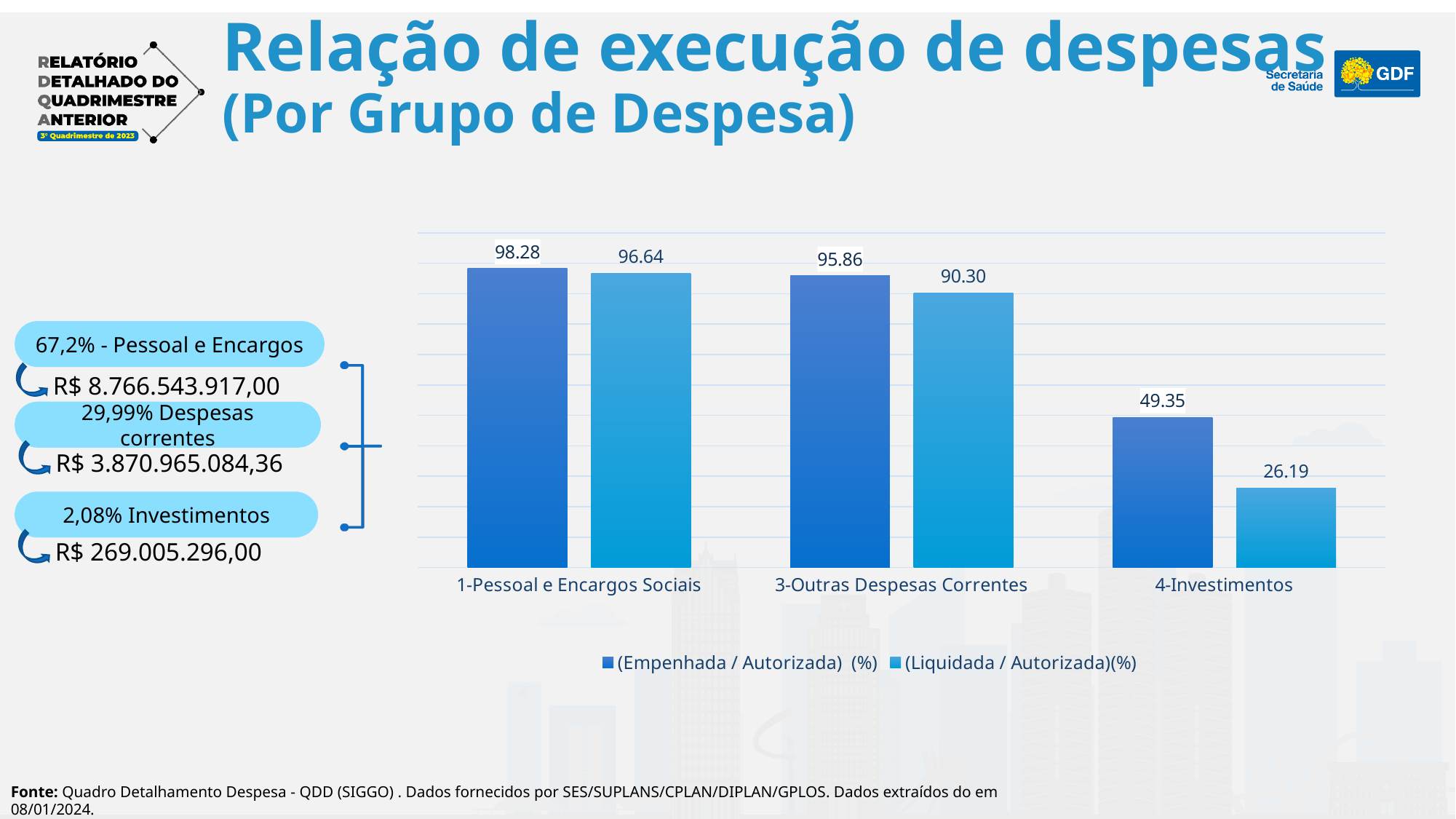
Which is larger: the (Liquidada / Autorizada)(%) value for 3-Outras Despesas Correntes or the (Empenhada / Autorizada) (%) value for 4-Investimentos? (Liquidada / Autorizada)(%) for 3-Outras Despesas Correntes What is the difference between the (Empenhada / Autorizada) (%) and (Liquidada / Autorizada)(%) values for 4-Investimentos? 23.16 What is the (Empenhada / Autorizada) (%) value for 1-Pessoal e Encargos Sociais? 98.28 Which category has the highest (Liquidada / Autorizada)(%) value? 1-Pessoal e Encargos Sociais How many categories are shown on the x axis of the chart? 3 What is the (Liquidada / Autorizada)(%) value for 3-Outras Despesas Correntes? 90.30 Which category has the lowest (Empenhada / Autorizada) (%) value? 4-Investimentos How many series does the chart legend list? 2 What kind of chart is shown on the slide? Bar chart What is the (Liquidada / Autorizada)(%) value for 4-Investimentos? 26.19 Do the (Empenhada / Autorizada) (%) values rise or fall from left to right across the categories? Fall What is the difference between the (Empenhada / Autorizada) (%) values for 1-Pessoal e Encargos Sociais and 3-Outras Despesas Correntes? 2.42